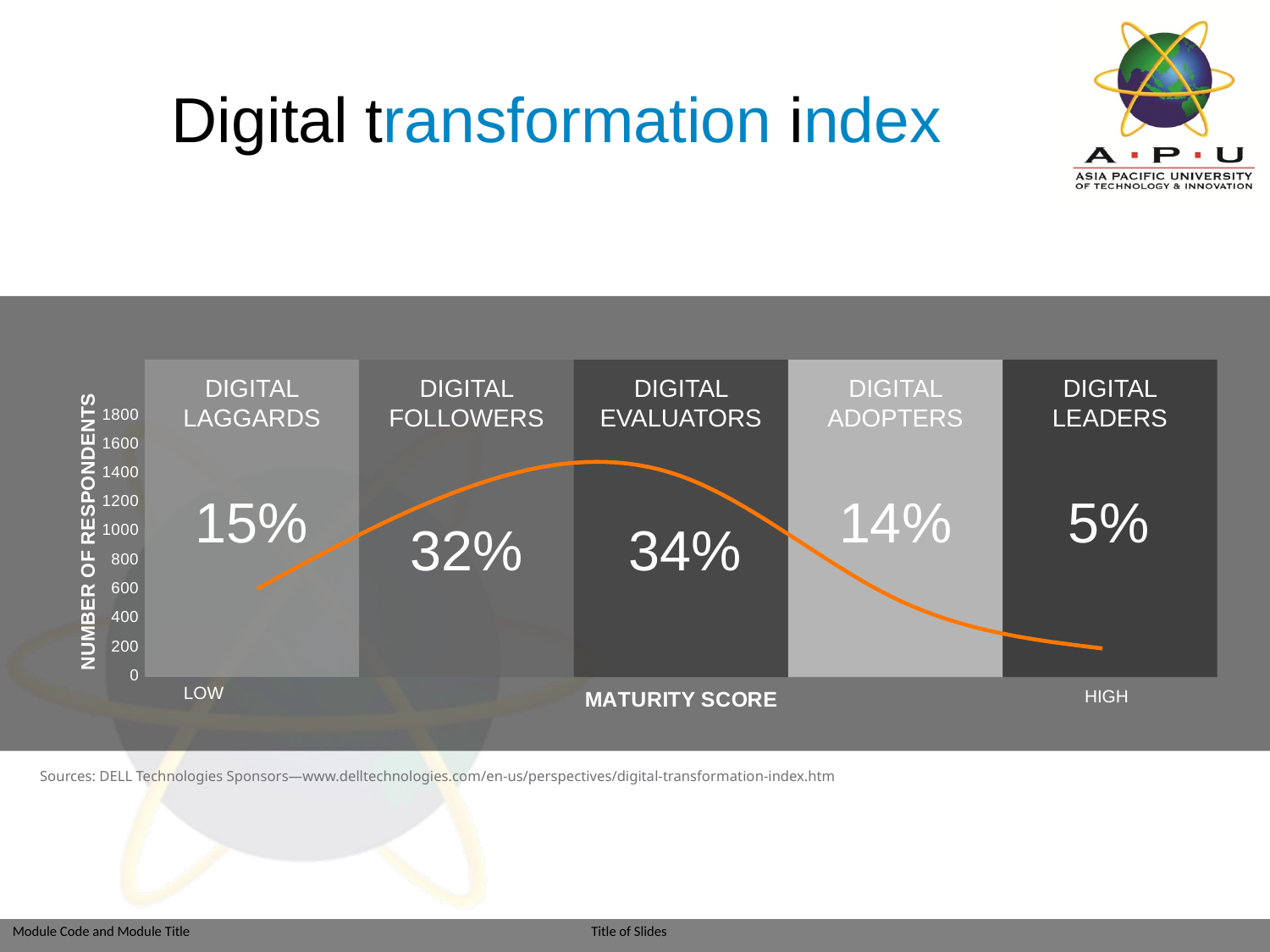
What percentage is shown for Digital Followers? 32% Which category has the highest percentage? Digital Evaluators Does the orange curve rise or fall from Digital Evaluators to Digital Leaders? fall Which has a larger percentage, Digital Laggards or Digital Adopters? Digital Laggards What percentage is shown for Digital Evaluators? 34% What percentage is shown for Digital Laggards? 15% What percentage is shown for Digital Leaders? 5% What is the label on the vertical axis of the chart? NUMBER OF RESPONDENTS What percentage is shown for Digital Adopters? 14% How many maturity categories are shown in the chart? 5 Which category has the lowest percentage? Digital Leaders What is the difference in percentage points between Digital Evaluators and Digital Followers? 2